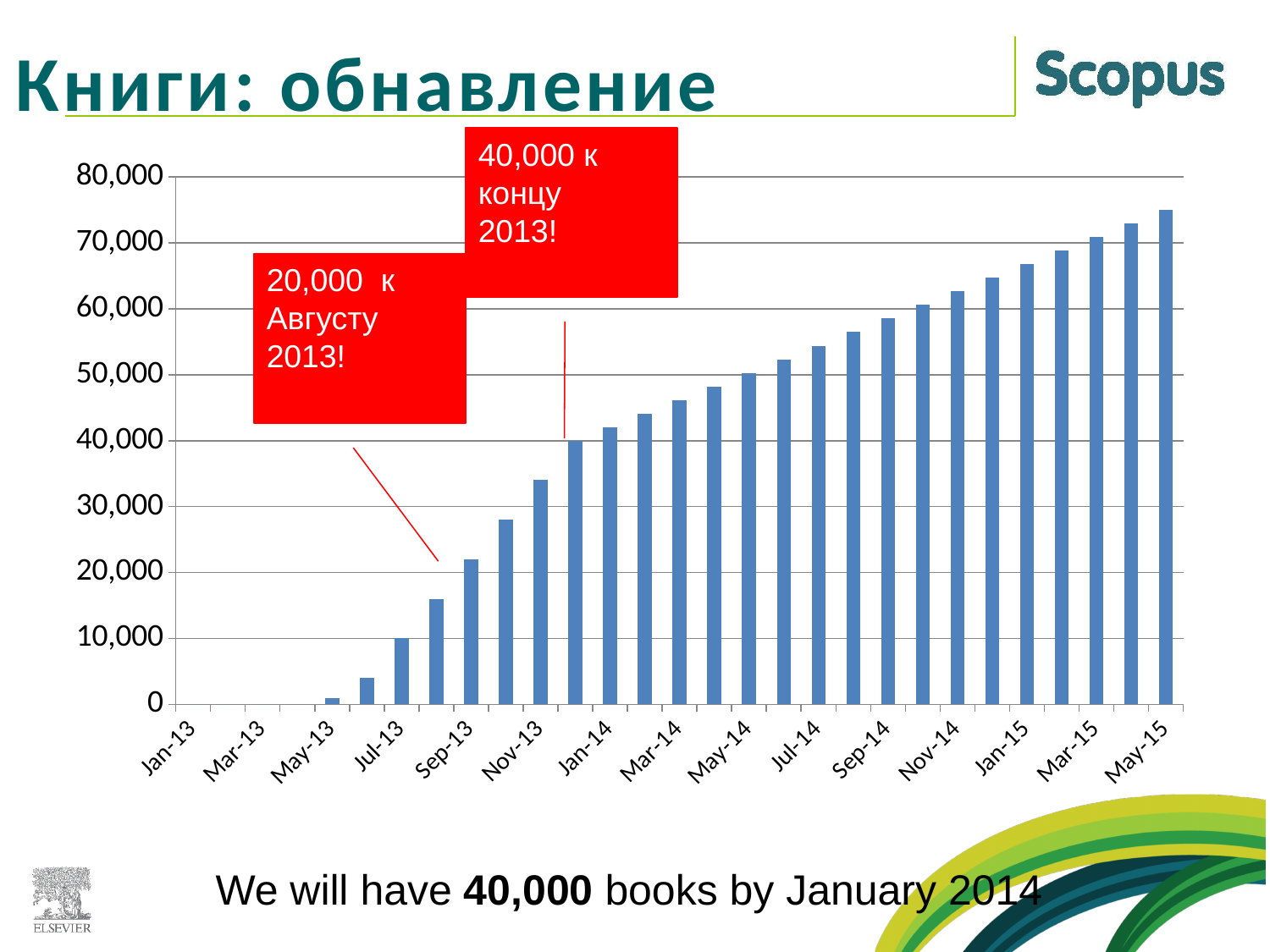
Is the value for Mar-14 greater or less than 50,000? less What kind of chart is shown on the slide? bar chart What is the highest value shown on the vertical axis? 80,000 Which is larger, the value for Jan-14 or the value for Jan-15? Jan-15 Is the value for Sep-13 greater or less than 20,000? greater Is the value for Sep-14 greater or less than 60,000? less Do the bar values rise or fall from Jan-13 to May-15? rise Which month has the highest bar in the chart? May-15 What does the upper red annotation box on the chart say? 40,000 к концу 2013!